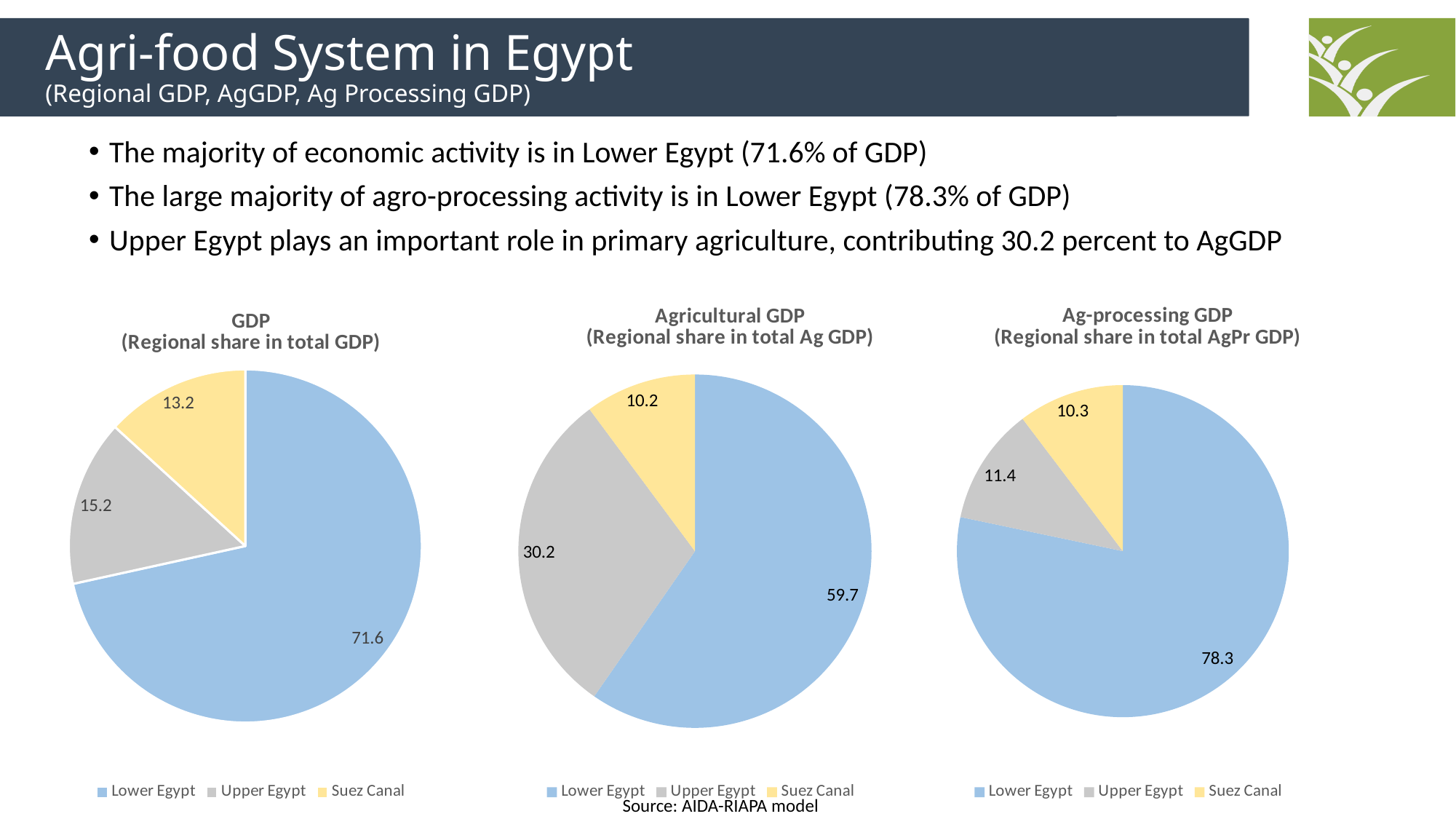
What kind of chart is the GDP (Regional share in total GDP) chart? Pie chart In the Ag-processing GDP pie chart, which region has the smallest share? Suez Canal In the Agricultural GDP pie chart, what is the value for Upper Egypt? 30.2 In the GDP (Regional share in total GDP) pie chart, which is larger, Upper Egypt or Suez Canal? Upper Egypt In the GDP (Regional share in total GDP) pie chart, what is the value for Lower Egypt? 71.6 In the GDP (Regional share in total GDP) pie chart, which region has the smallest share? Suez Canal In the Agricultural GDP pie chart, what is the difference between the Lower Egypt and Upper Egypt values? 29.5 In the Ag-processing GDP pie chart, what colour is the Lower Egypt slice? Blue In the Ag-processing GDP pie chart, what is the value for Suez Canal? 10.3 In the Agricultural GDP pie chart, which region has the largest share? Lower Egypt How many slices does the Ag-processing GDP pie chart have? 3 How many entries does the legend of the Agricultural GDP chart list? 3